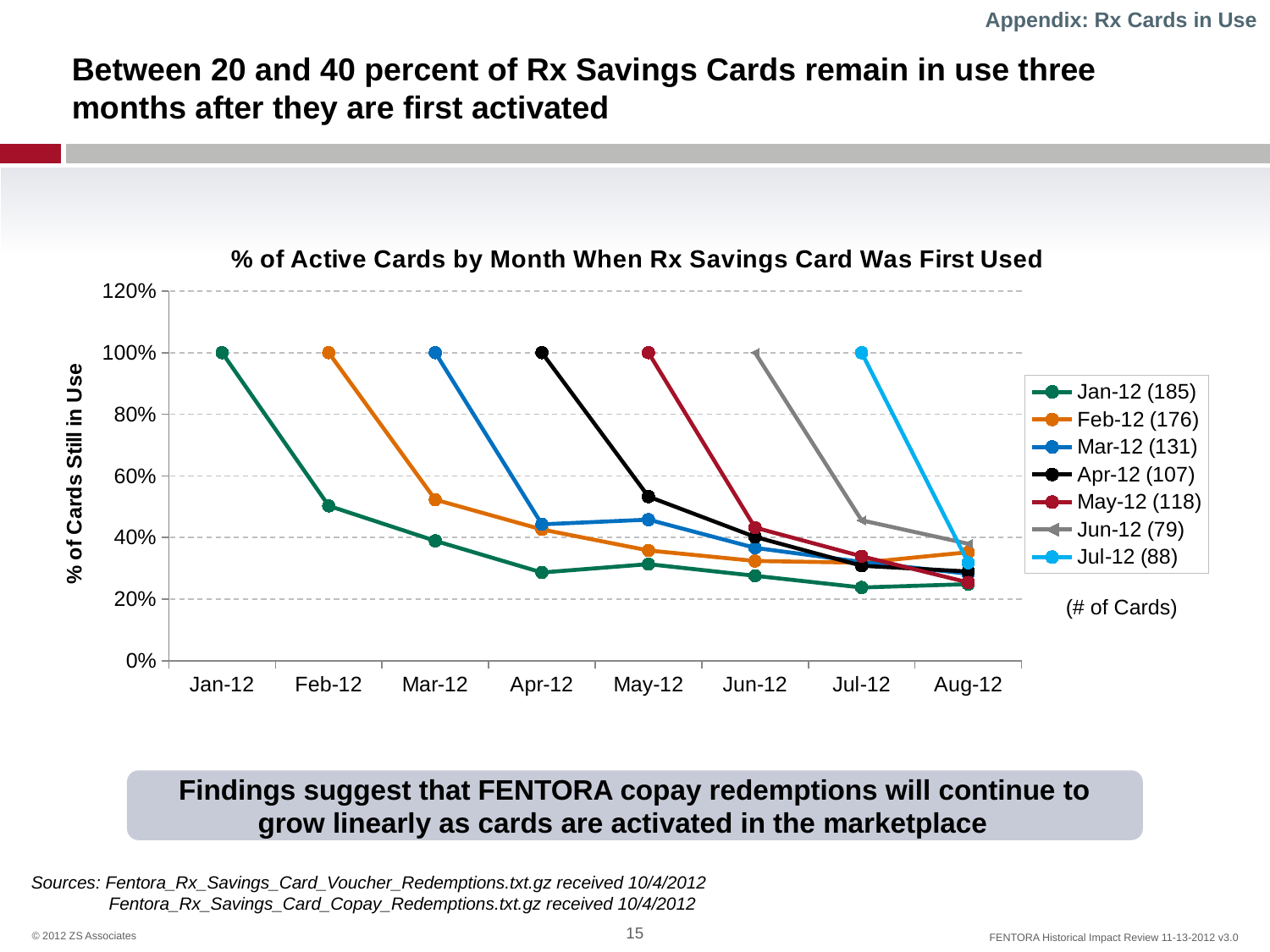
Does the Jan-12 (185) series rise or fall from Jan-12 to Aug-12? fall What is the value of the Jul-12 (88) series at Jul-12? 100% Is the value of the Jan-12 (185) series at Aug-12 greater or less than 40%? less At Aug-12, which is higher: the Feb-12 (176) series or the Jan-12 (185) series? Feb-12 (176) Is the value of the Apr-12 (107) series at May-12 greater or less than 40%? greater What is the value of the Jan-12 (185) series at Jan-12? 100% Is the value of the Jul-12 (88) series at Aug-12 greater or less than 20%? greater What kind of chart is shown on the slide? line chart What is the title of the chart? % of Active Cards by Month When Rx Savings Card Was First Used How many months are shown along the x axis? 8 How many series does the legend list? 7